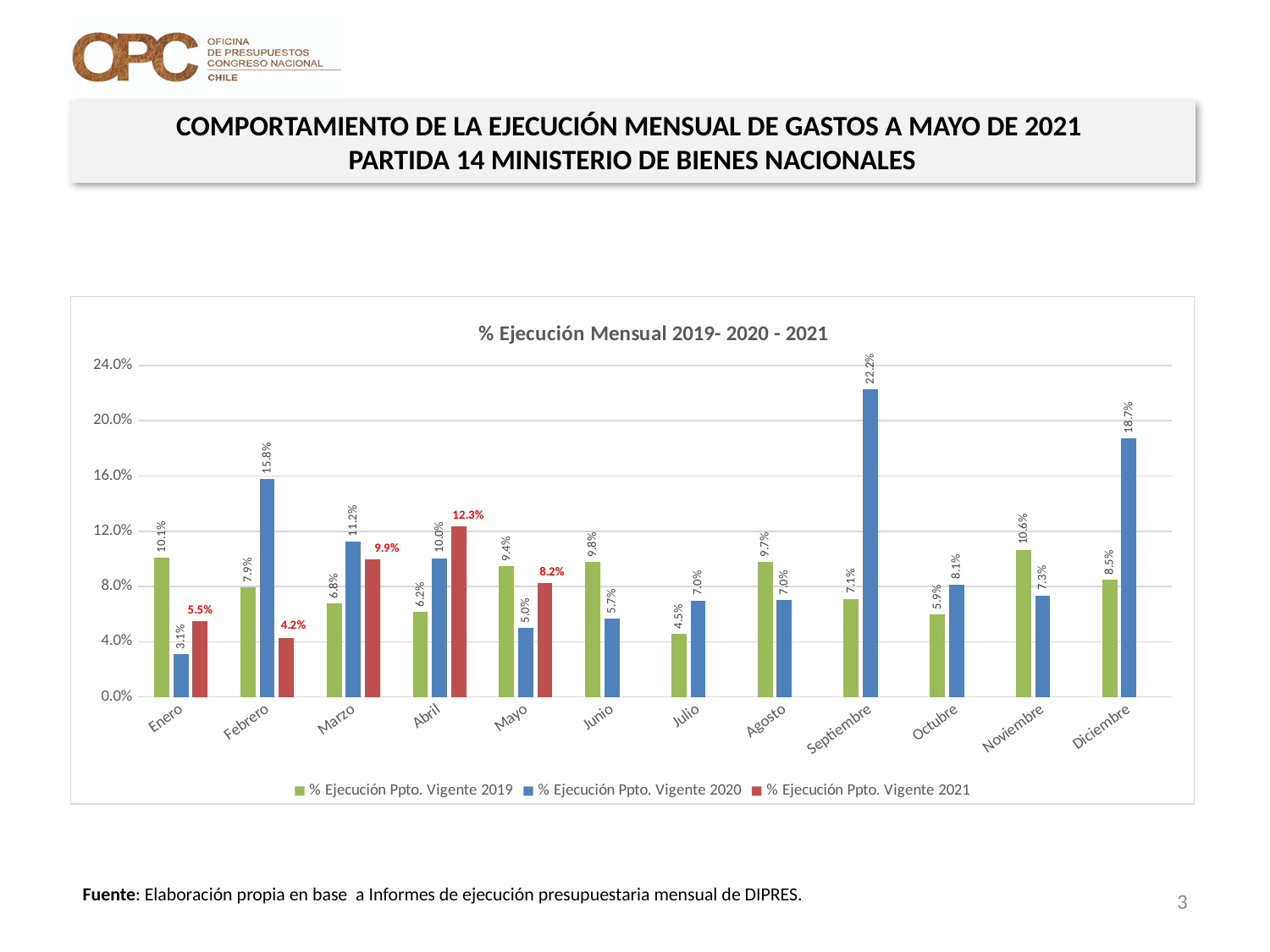
Does the % Ejecución Ppto. Vigente 2021 series rise or fall from Enero to Febrero? Fall How many months have a value for the % Ejecución Ppto. Vigente 2021 series? 5 What is the difference between the 2020 and 2019 values in Febrero? 7.9% What is the title of the chart? % Ejecución Mensual 2019- 2020 - 2021 What is the value for % Ejecución Ppto. Vigente 2019 in Noviembre? 10.6% What kind of chart is shown? Bar chart How many series does the legend list? 3 What is the value for % Ejecución Ppto. Vigente 2021 in Abril? 12.3% In which month is the % Ejecución Ppto. Vigente 2020 series highest? Septiembre What is the value for % Ejecución Ppto. Vigente 2020 in Septiembre? 22.2% Which is larger in Mayo: the 2019 value or the 2021 value? 2019 value (9.4%) In which month is the % Ejecución Ppto. Vigente 2019 series lowest? Julio